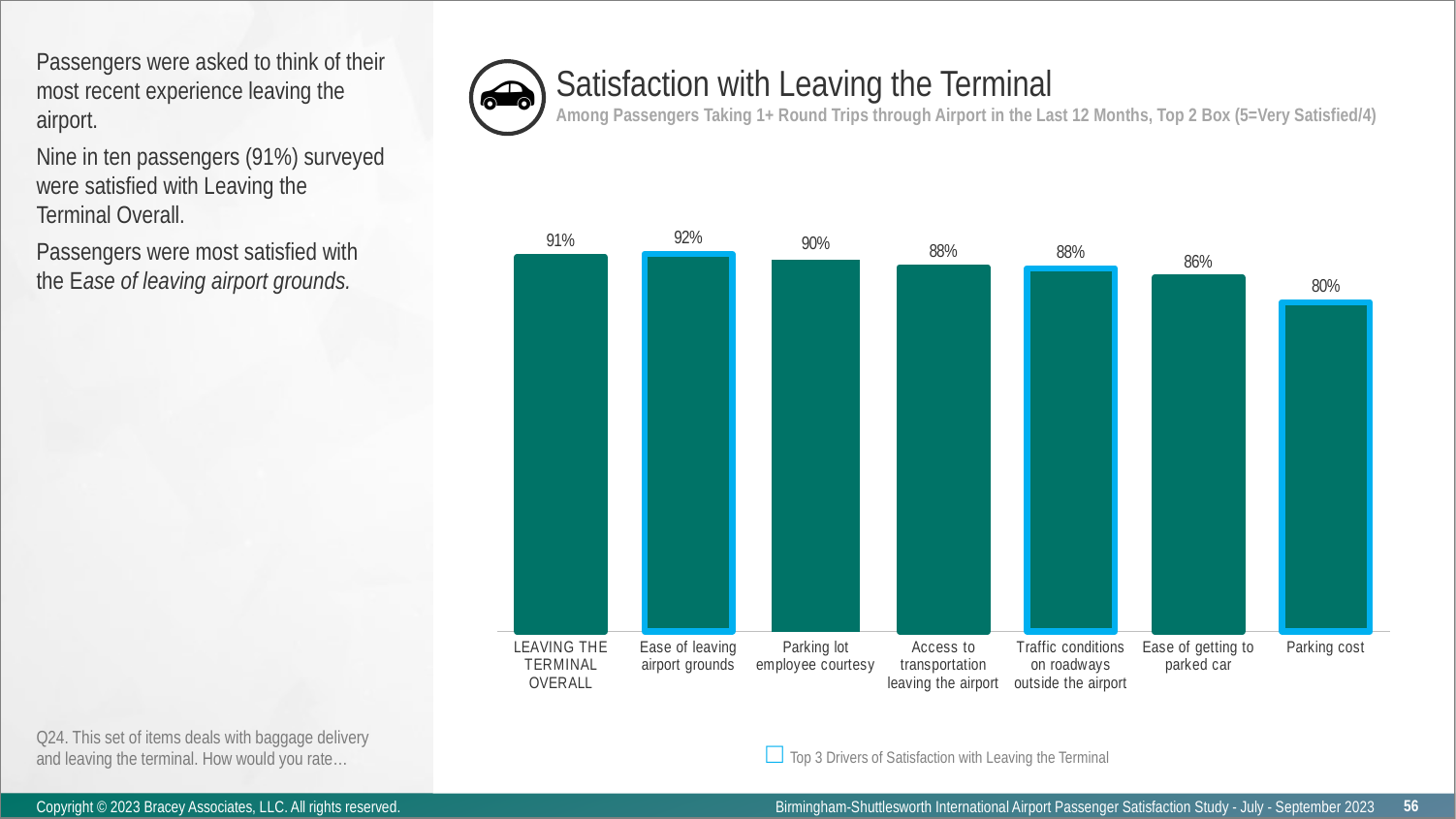
How many categories are shown in the chart? 7 What is the satisfaction value for Ease of leaving airport grounds? 92% What kind of chart is shown on the slide? Bar chart What is the satisfaction value for Parking lot employee courtesy? 90% What is the satisfaction value for Parking cost? 80% What is the title of the chart? Satisfaction with Leaving the Terminal What do the blue outlines around some bars indicate, according to the legend? Top 3 Drivers of Satisfaction with Leaving the Terminal Which category has the lowest satisfaction value? Parking cost What is the satisfaction value for LEAVING THE TERMINAL OVERALL? 91% Which category has the highest satisfaction value? Ease of leaving airport grounds What is the difference between the values for Ease of leaving airport grounds and Parking cost? 12% Which is larger, the value for Ease of getting to parked car or the value for Parking cost? Ease of getting to parked car